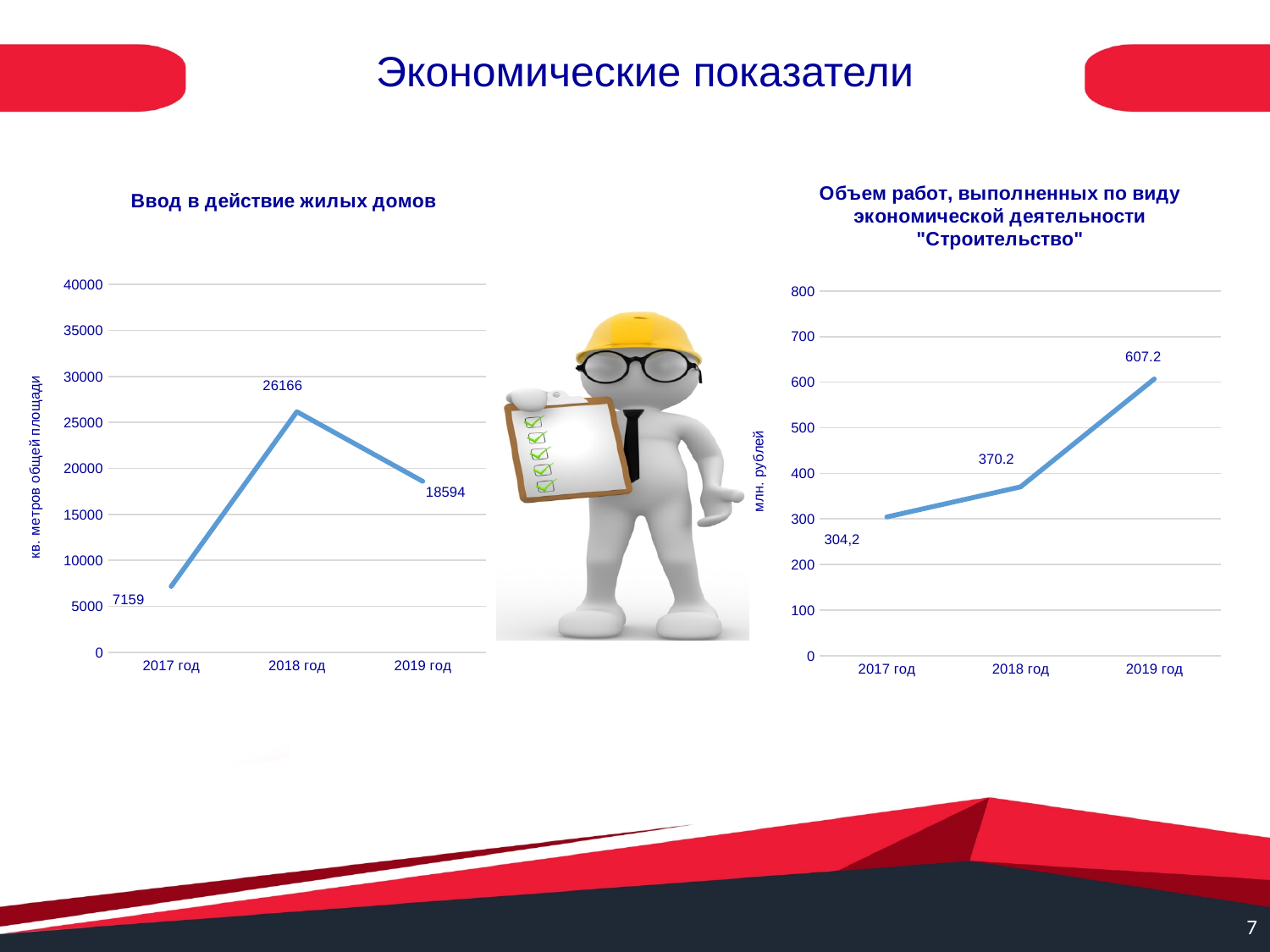
What kind of chart is 'Ввод в действие жилых домов'? line chart In the chart 'Объем работ, выполненных по виду экономической деятельности "Строительство"', what is the value for 2019 год? 607.2 How many data points are plotted in the chart 'Объем работ, выполненных по виду экономической деятельности "Строительство"'? 3 In the chart 'Объем работ, выполненных по виду экономической деятельности "Строительство"', what is the value for 2017 год? 304,2 In the chart 'Ввод в действие жилых домов', is the value for 2019 год greater or less than 20000? less In the chart 'Ввод в действие жилых домов', what is the value for 2017 год? 7159 In the chart 'Объем работ, выполненных по виду экономической деятельности "Строительство"', do the values rise or fall from 2017 год to 2019 год? rise In the chart 'Ввод в действие жилых домов', what is the difference between the values for 2018 год and 2019 год? 7572 In the chart 'Ввод в действие жилых домов', what is the value for 2018 год? 26166 In the chart 'Ввод в действие жилых домов', which year has the highest value? 2018 год In the chart 'Объем работ, выполненных по виду экономической деятельности "Строительство"', what is the difference between the values for 2019 год and 2018 год? 237.0 In the chart 'Ввод в действие жилых домов', which year has the lowest value? 2017 год